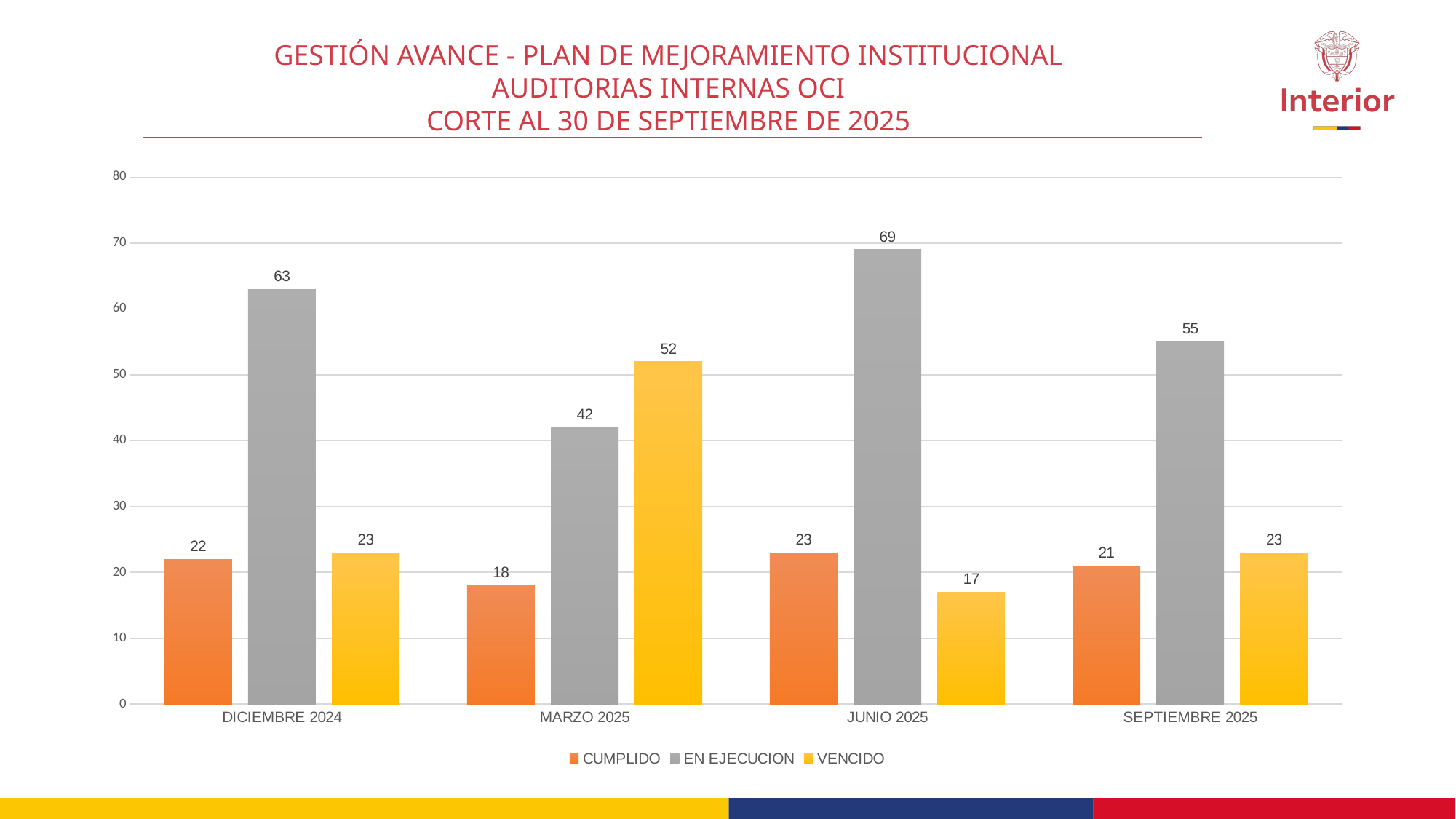
What kind of chart is shown on the slide? Bar chart Which period has the highest EN EJECUCION value? JUNIO 2025 Which colour represents the VENCIDO series in the legend? Yellow What is the difference between the EN EJECUCION values for JUNIO 2025 and SEPTIEMBRE 2025? 14 Which is larger, the VENCIDO value for MARZO 2025 or the EN EJECUCION value for MARZO 2025? VENCIDO for MARZO 2025 How many series does the legend list? 3 How many periods are shown on the x axis? 4 What is the value of VENCIDO for MARZO 2025? 52 What is the value of CUMPLIDO for SEPTIEMBRE 2025? 21 What is the value of EN EJECUCION for JUNIO 2025? 69 Which period has the lowest VENCIDO value? JUNIO 2025 Is the EN EJECUCION value for DICIEMBRE 2024 greater or less than 60? greater